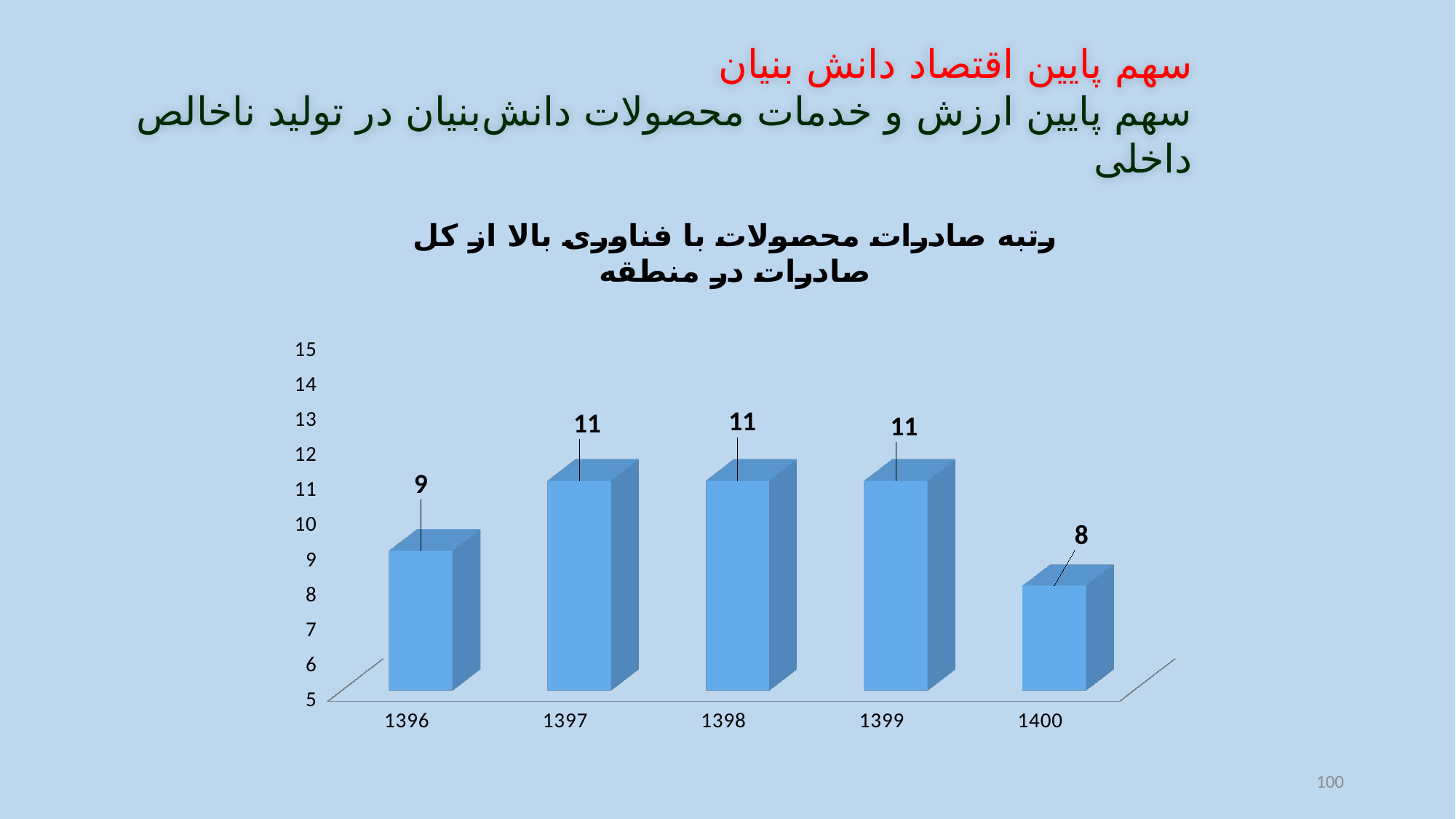
What is the value for 1400? 8 Which year has the lowest value? 1400 How many years are shown on the x axis? 5 Which is larger, the value for 1396 or the value for 1400? 1396 How many years share the highest value of 11? 3 What is the value for 1398? 11 What is the value for 1396? 9 What is the difference between the values for 1397 and 1400? 3 Is the value for 1397 greater or less than 10? greater What is the difference between the values for 1396 and 1399? 2 What kind of chart is shown on the slide? bar chart Does the value rise or fall from 1399 to 1400? fall